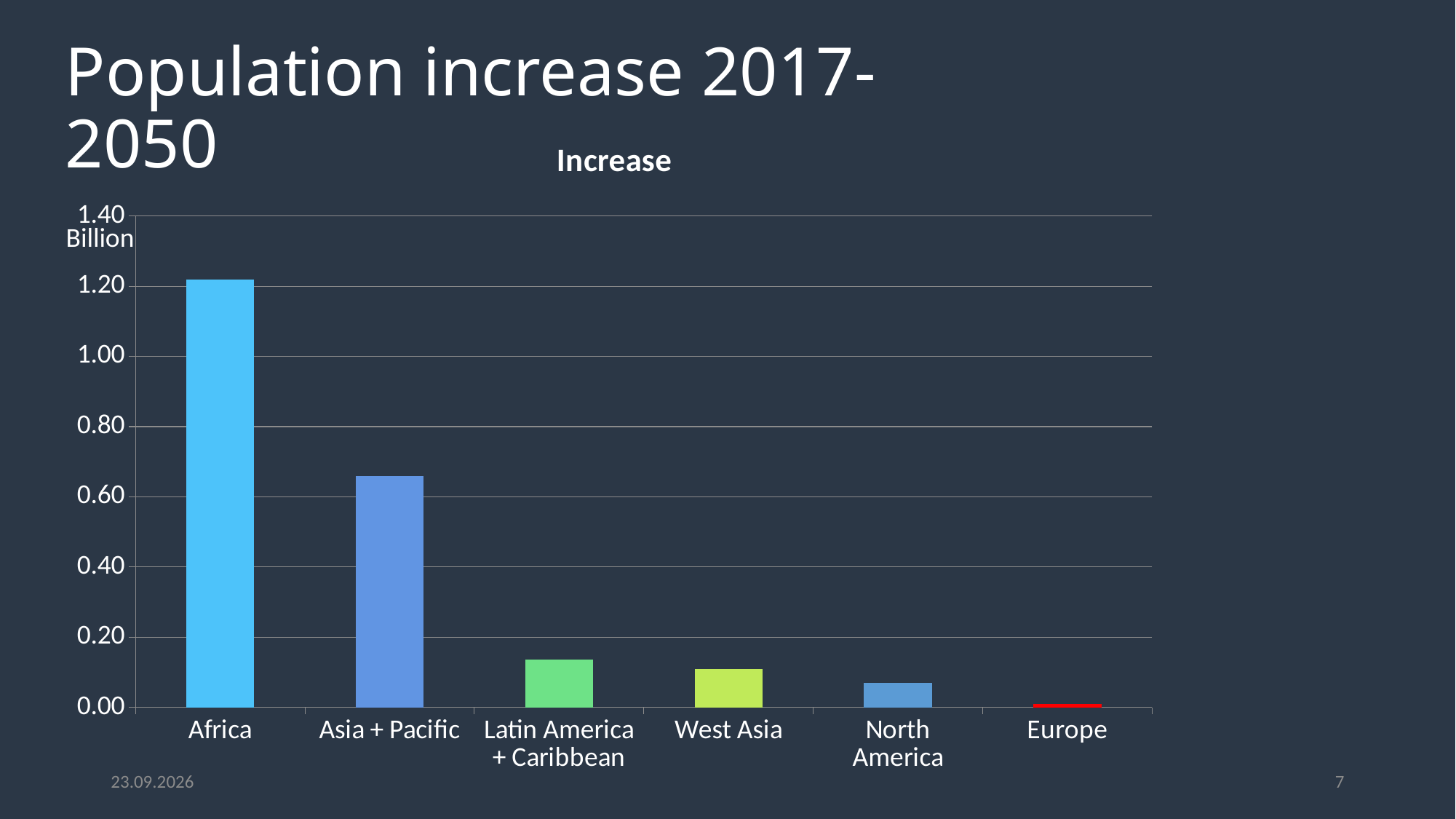
Which region has the lowest population increase in the chart? Europe How many regions are shown on the x axis of the chart? 6 Which has the larger population increase, Asia + Pacific or Latin America + Caribbean? Asia + Pacific Is the value for Africa greater or less than 1.00? greater Is the value for Latin America + Caribbean greater or less than 0.20? less Do the bar values rise or fall from left to right across the chart? fall Is the value for Asia + Pacific greater or less than 0.80? less Which region has the highest population increase in the chart? Africa What unit is shown on the vertical axis of the chart? Billion What kind of chart is shown on the slide? bar chart What is the title of the chart? Increase Which has the larger population increase, West Asia or North America? West Asia